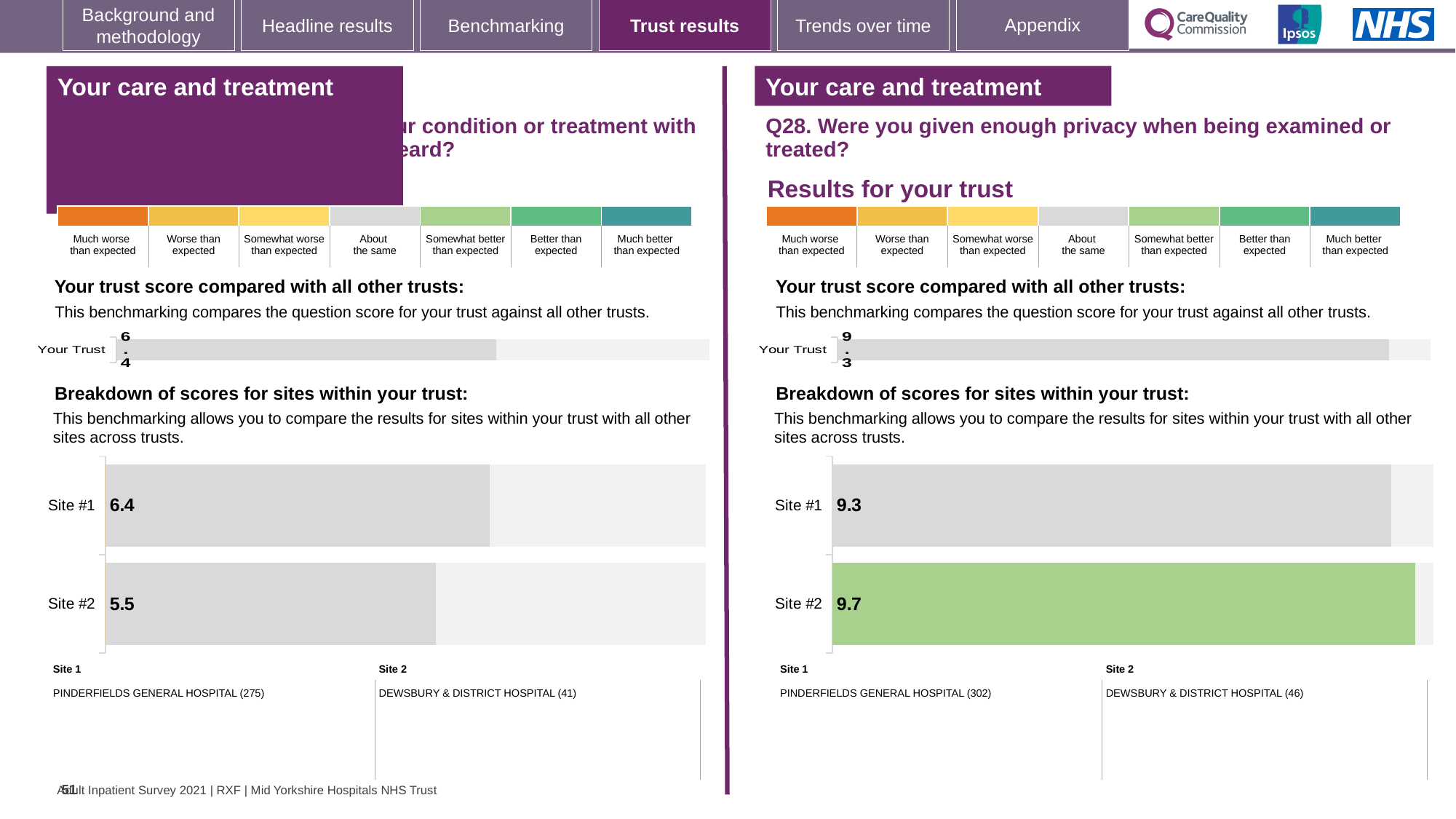
On the Q28 site breakdown chart, what is the difference between the Site #2 and Site #1 scores? 0.4 What type of chart is used for the site breakdown on the Q28 panel? Bar chart On the Q28 site breakdown chart, which site has the highest score? Site #2 On the Q28 (privacy when being examined or treated) site breakdown chart, what is the score for Site #1? 9.3 How many sites are shown in the Q28 site breakdown chart? 2 On the left-hand panel's site breakdown chart, which site has the lowest score? Site #2 On the left-hand panel, what is the 'Your Trust' score shown in the trust comparison bar? 6.4 On the Q28 panel, what is the 'Your Trust' score shown in the trust comparison bar? 9.3 On the left-hand panel's site breakdown chart, what is the score for Site #2? 5.5 On the Q28 (privacy when being examined or treated) site breakdown chart, what is the score for Site #2? 9.7 On the left-hand panel's site breakdown chart, what is the difference between the Site #1 and Site #2 scores? 0.9 On the left-hand panel's site breakdown chart, what is the score for Site #1? 6.4